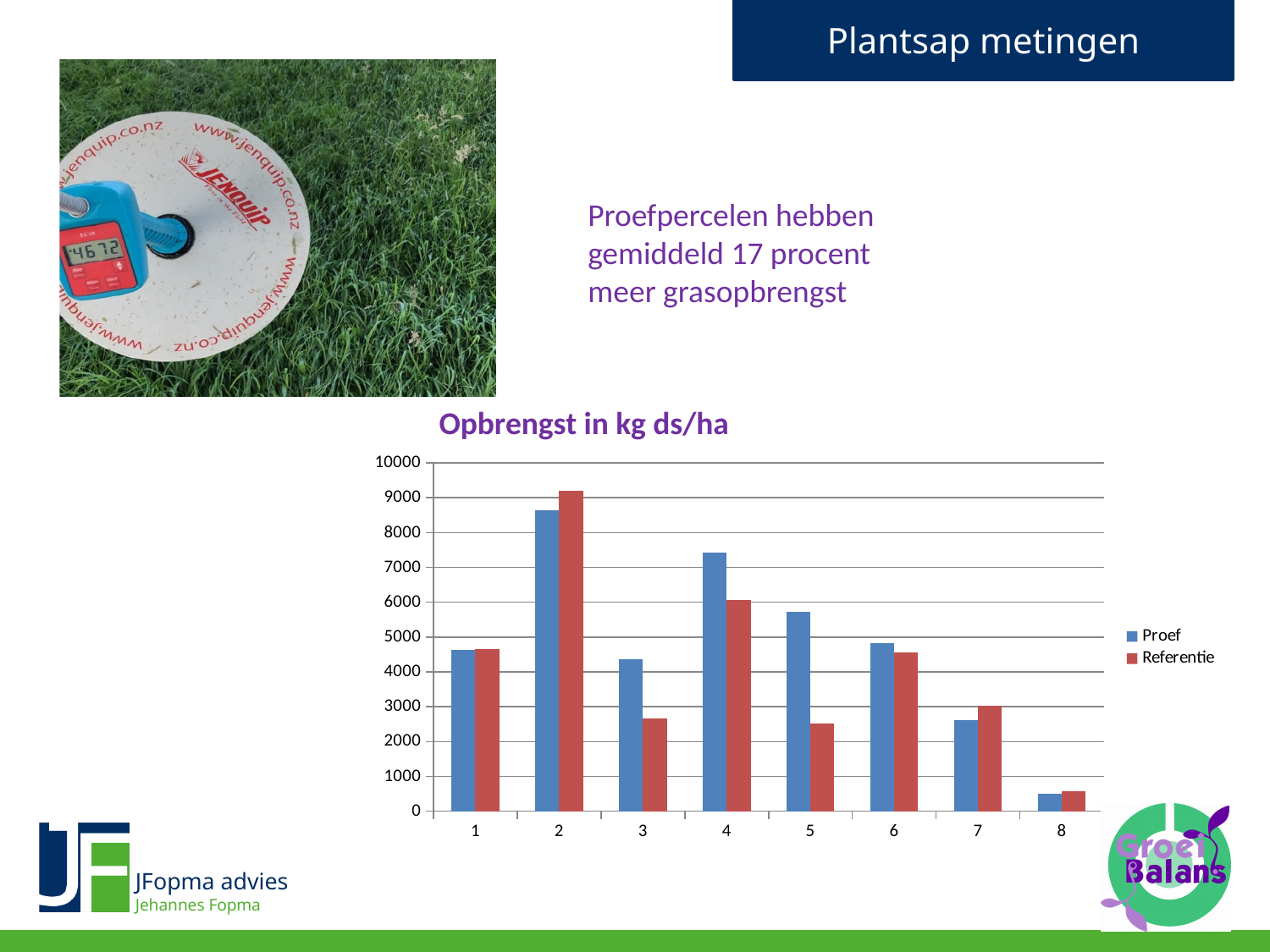
Which category has the lowest Referentie value? 8 What is the title of the chart? Opbrengst in kg ds/ha Which series is shown in red in the chart? Referentie For category 3, which series has the larger value, Proef or Referentie? Proef How many series does the legend list? 2 Is the Referentie value for category 5 greater or less than 3000? less For category 7, which series has the larger value, Proef or Referentie? Referentie Is the Proef value for category 2 greater or less than 8000? greater Is the Proef value for category 4 greater or less than 7000? greater What kind of chart is shown on the slide? bar chart How many categories are shown on the x axis of the chart? 8 Which category has the highest Proef value? 2